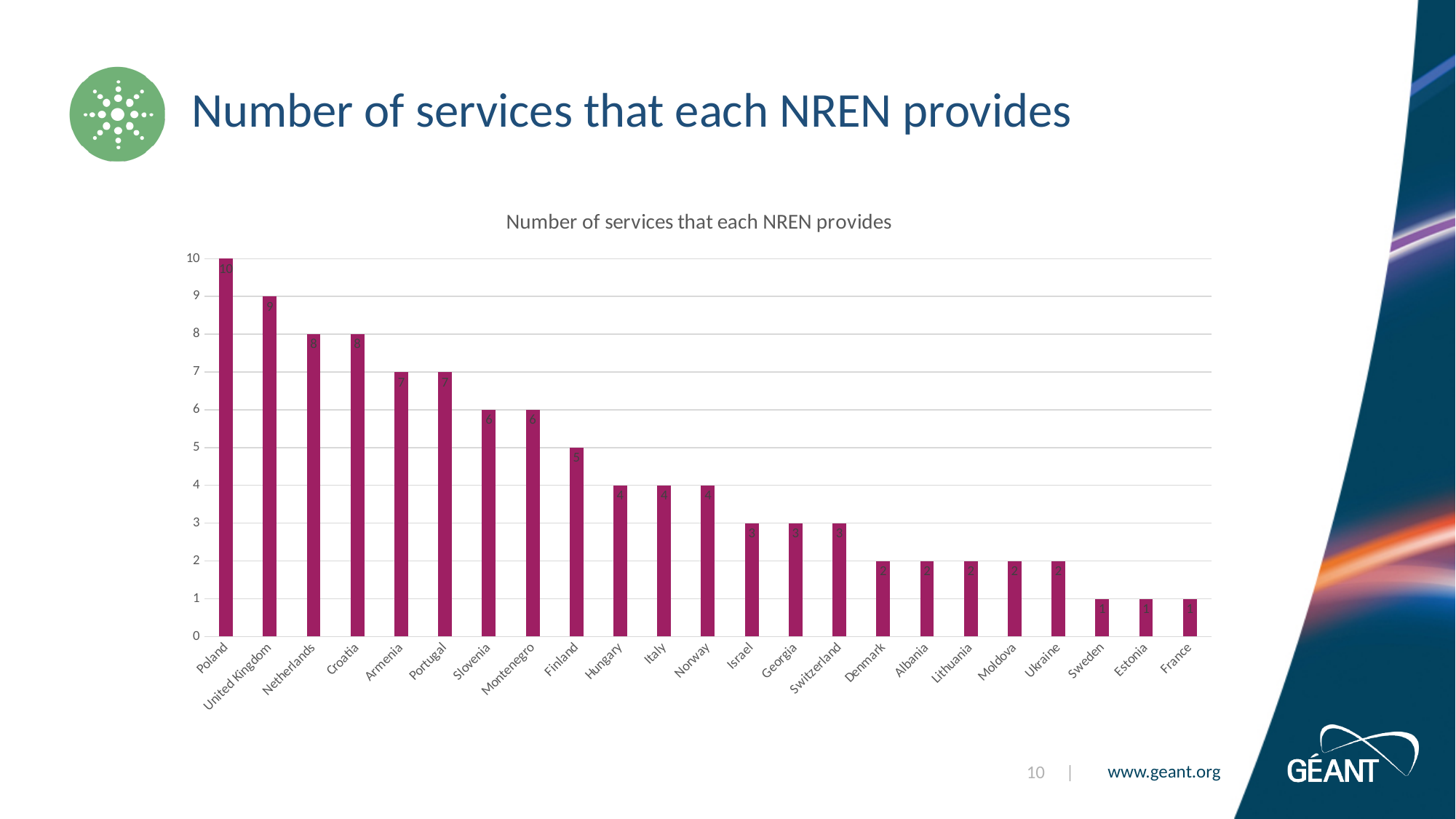
Do the values rise or fall moving from left to right along the x axis? Fall How many NRENs (categories) are shown on the x axis? 23 Which NREN provides the highest number of services? Poland How many services does Finland provide? 5 What is the difference between the values for Poland and Croatia? 2 What type of chart is shown on the slide? Bar chart What colour are the bars in the chart? Magenta How many services does Poland provide according to the chart? 10 What is the value shown for Switzerland? 3 What is the value shown for the United Kingdom? 9 Which has a higher value, Armenia or Hungary? Armenia What is the title of the chart? Number of services that each NREN provides